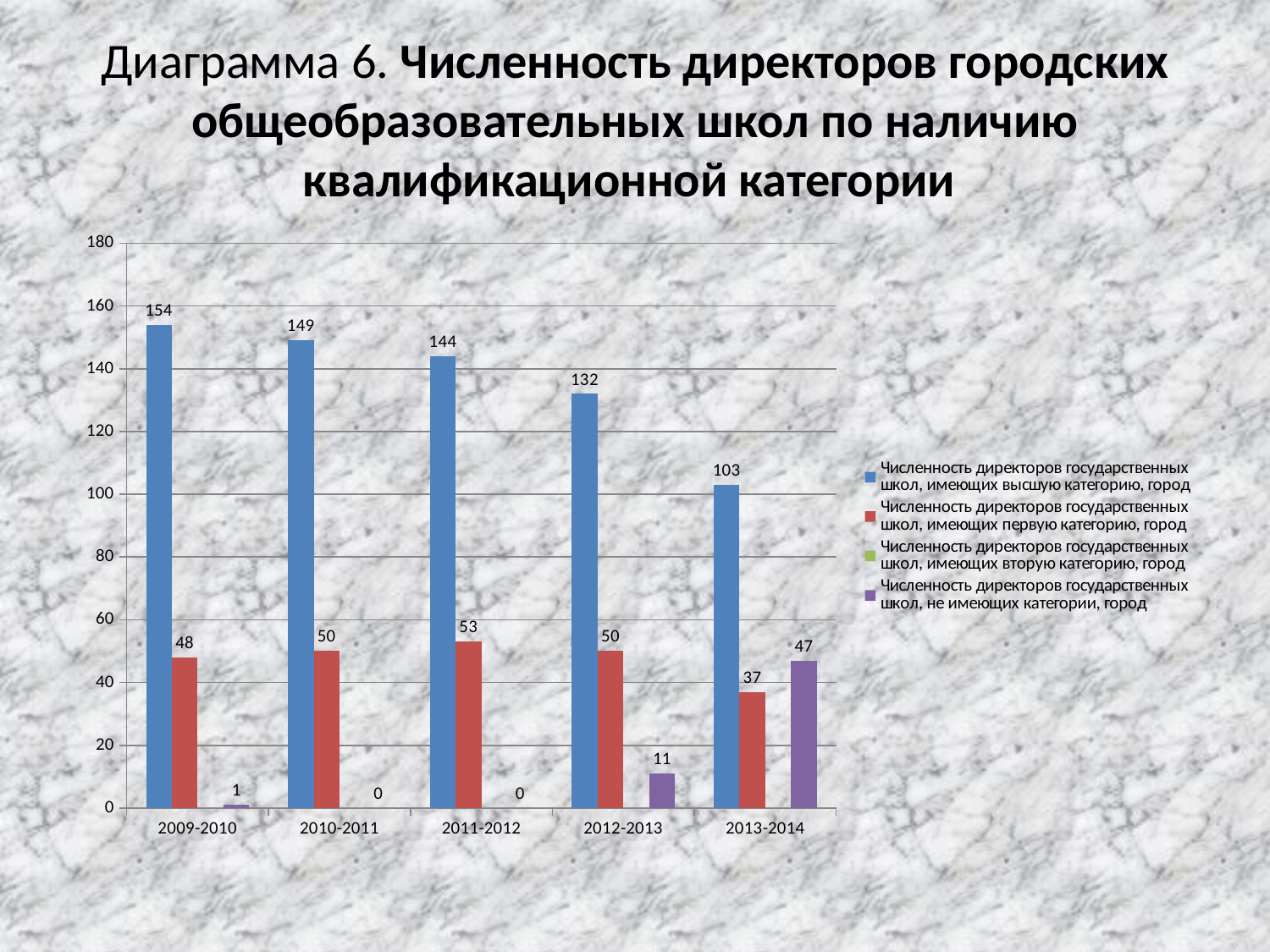
How many series does the legend list? 4 What is the number of directors with the first category (первую категорию) in 2011-2012? 53 Which is larger in 2013-2014: the number of directors with the first category or the number without a category? Number without a category (47) What is the number of directors without a category (не имеющих категории) in 2013-2014? 47 What is the number of directors without a category in 2012-2013? 11 In which school year is the number of directors with the highest category the lowest? 2013-2014 What type of chart is shown on the slide? Bar chart How many school years are shown on the x axis? 5 What is the number of directors with the highest category (высшую категорию) in 2009-2010? 154 How does the number of directors with the highest category change from 2009-2010 to 2013-2014? It falls What is the difference between the number of directors with the highest category in 2009-2010 and in 2013-2014? 51 In which school year is the number of directors with the first category the highest? 2011-2012